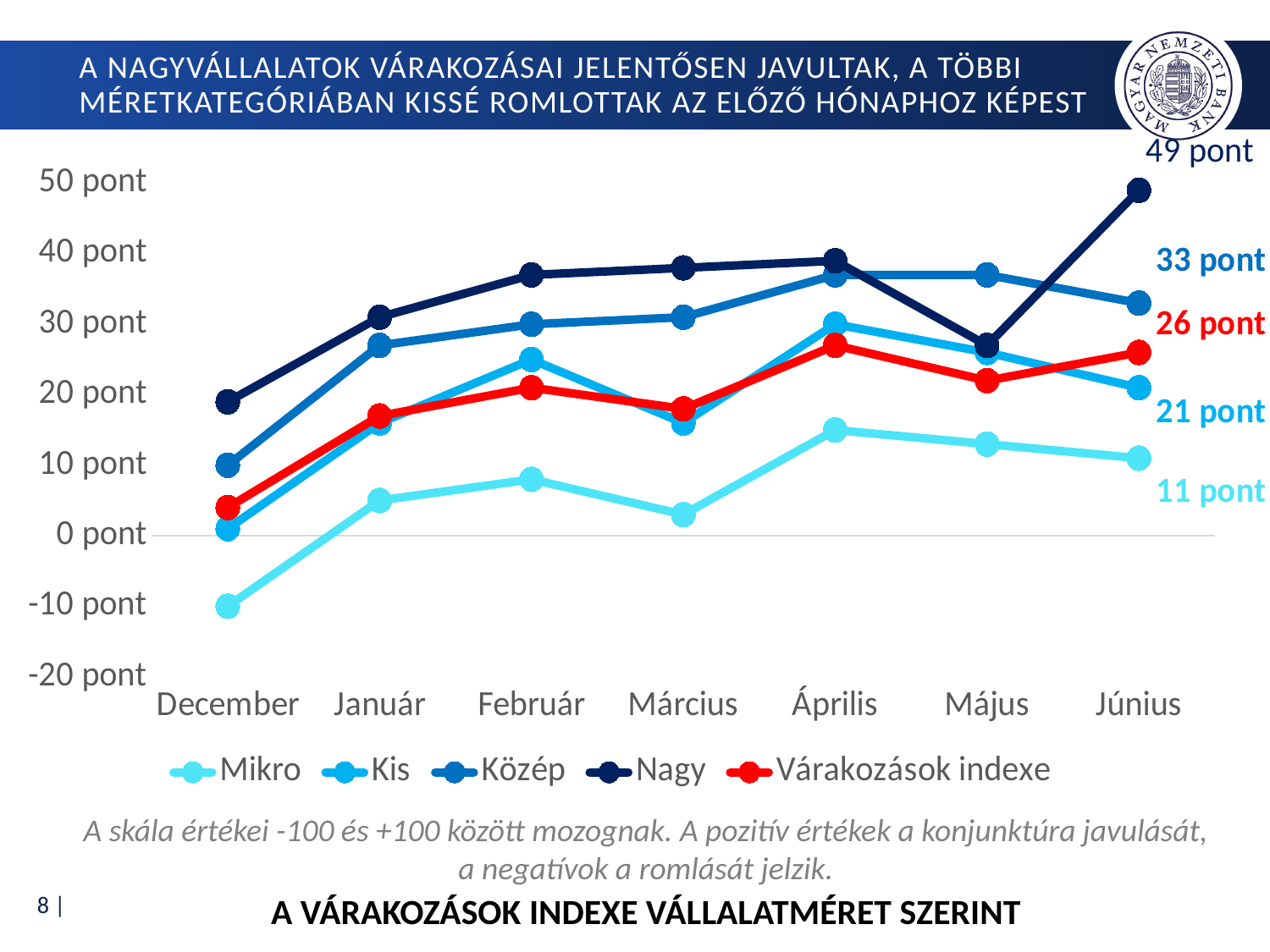
What is the value for Várakozások indexe in Június? 26 pont How many series does the legend list? 5 What is the value for Közép in Június? 33 pont What is the value for Mikro in Június? 11 pont Is the value for Mikro in December greater or less than 0 pont? less What is the difference between the Nagy and Mikro values in Június? 38 pont In Június, which is larger: the value for Kis or the value for Közép? Közép Which series has the highest value in Június? Nagy Which series has the lowest value in Június? Mikro How many months are shown on the x axis? 7 What kind of chart is shown on the slide? line chart What is the value for Nagy in Június? 49 pont